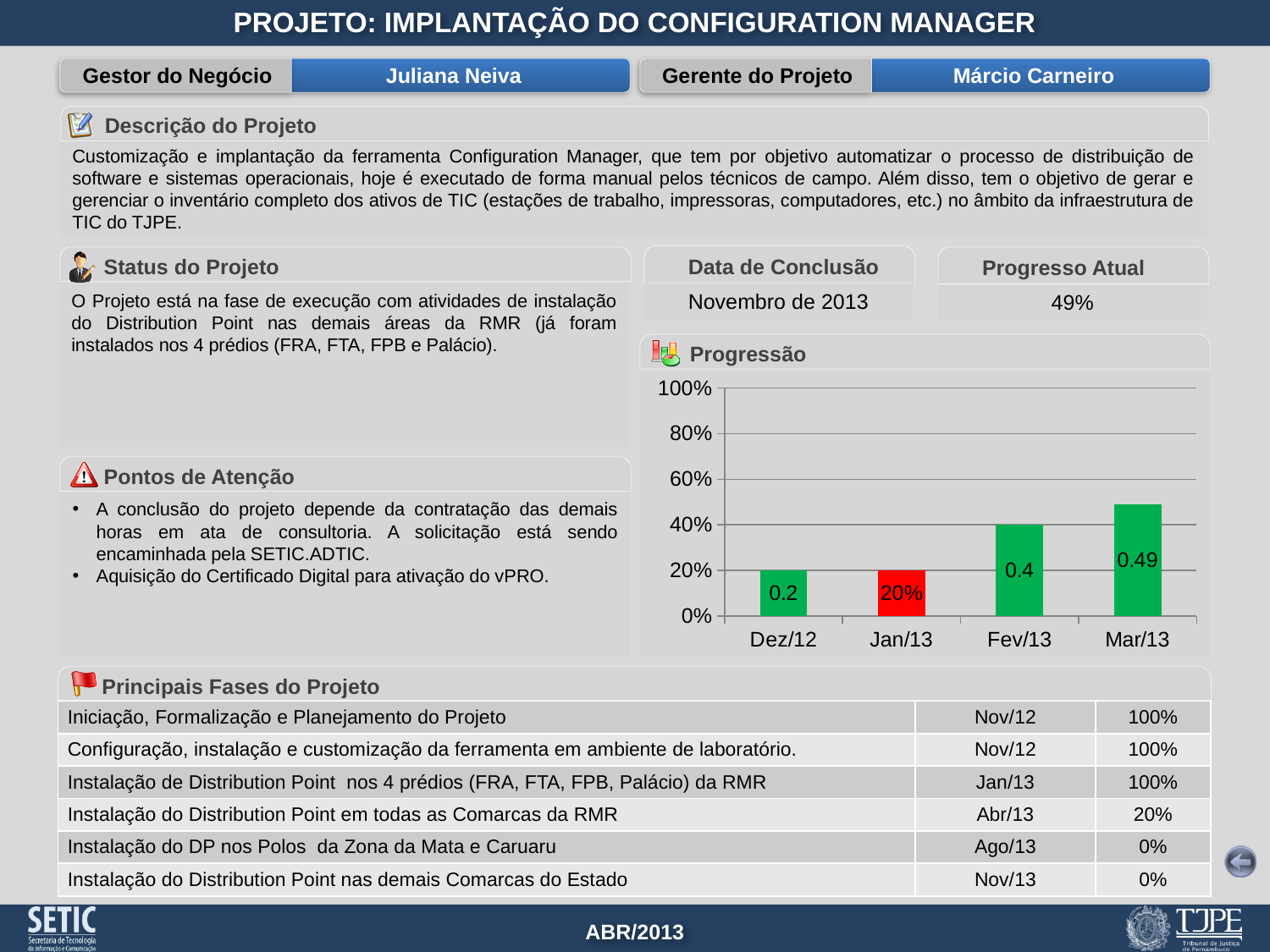
Do the values in the Progressão chart generally rise or fall from Dez/12 to Mar/13? rise What is the difference between the Mar/13 and Fev/13 values in the Progressão chart? 0.09 Which bar in the Progressão chart is coloured red? Jan/13 What is the value labelled on the Dez/12 bar in the Progressão chart? 0.2 How many categories are plotted on the x axis of the Progressão chart? 4 Which month has the highest bar in the Progressão chart? Mar/13 In the Progressão chart, which is larger, the value for Fev/13 or the value for Jan/13? Fev/13 What is the value labelled on the Jan/13 bar in the Progressão chart? 20% What is the value labelled on the Mar/13 bar in the Progressão chart? 0.49 Is the value for Mar/13 in the Progressão chart greater or less than 40%? greater What is the value labelled on the Fev/13 bar in the Progressão chart? 0.4 What type of chart is shown under "Progressão"? bar chart